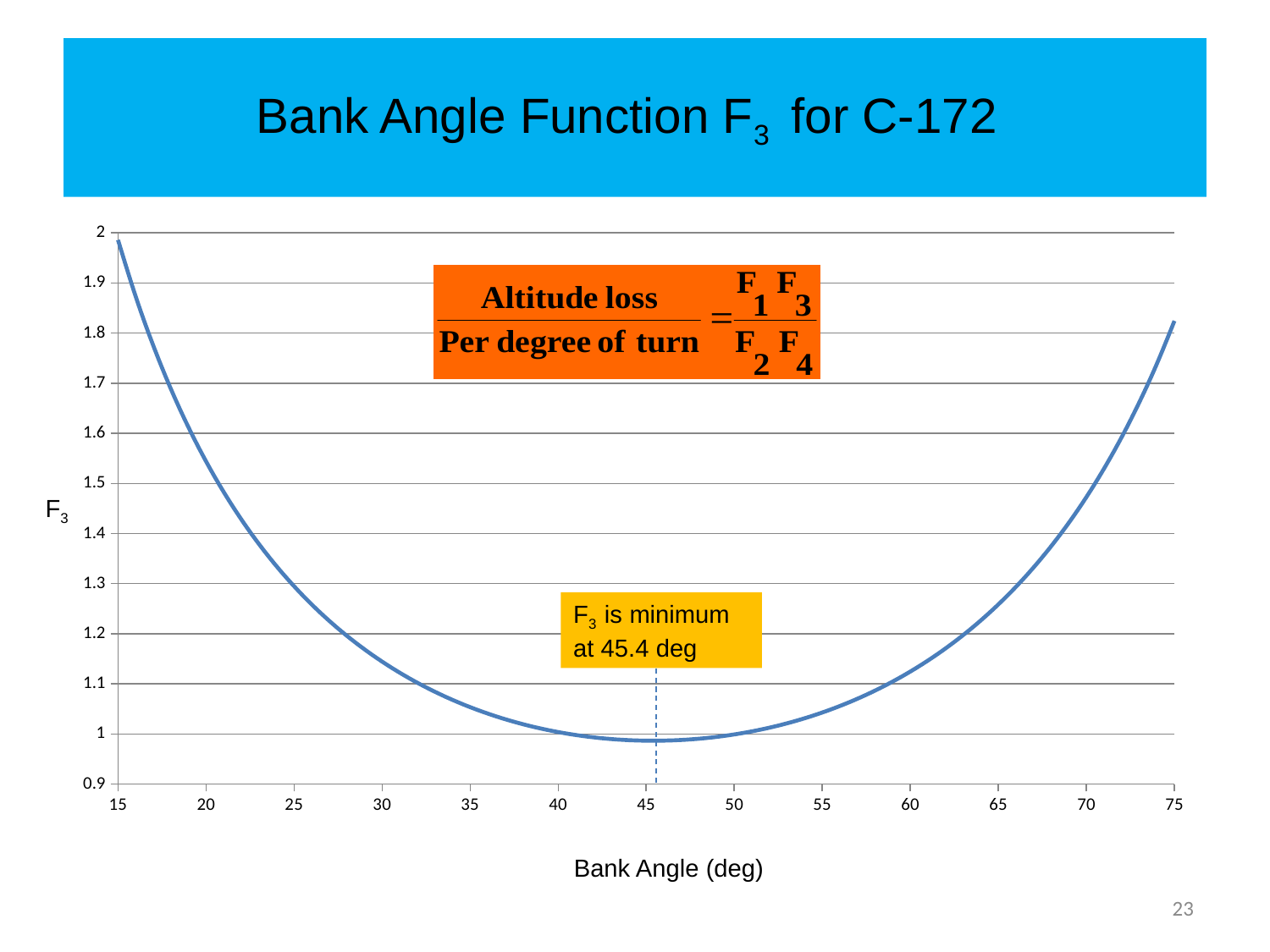
Is the value of F3 at a bank angle of 15 deg greater or less than 1.9? greater Does F3 rise or fall as the bank angle increases from 50 deg to 75 deg? rise Which has the larger F3 value: a bank angle of 15 deg or 75 deg? 15 deg Does F3 rise or fall as the bank angle increases from 15 deg to 45 deg? fall What kind of chart is shown on the slide? line chart Is the value of F3 at a bank angle of 20 deg greater or less than 1.5? greater At what bank angle is F3 at its minimum, according to the annotation on the chart? 45.4 deg Is the value of F3 at a bank angle of 30 deg greater or less than 1.2? less What is the label of the x axis? Bank Angle (deg) What is the title of the chart? Bank Angle Function F3 for C-172